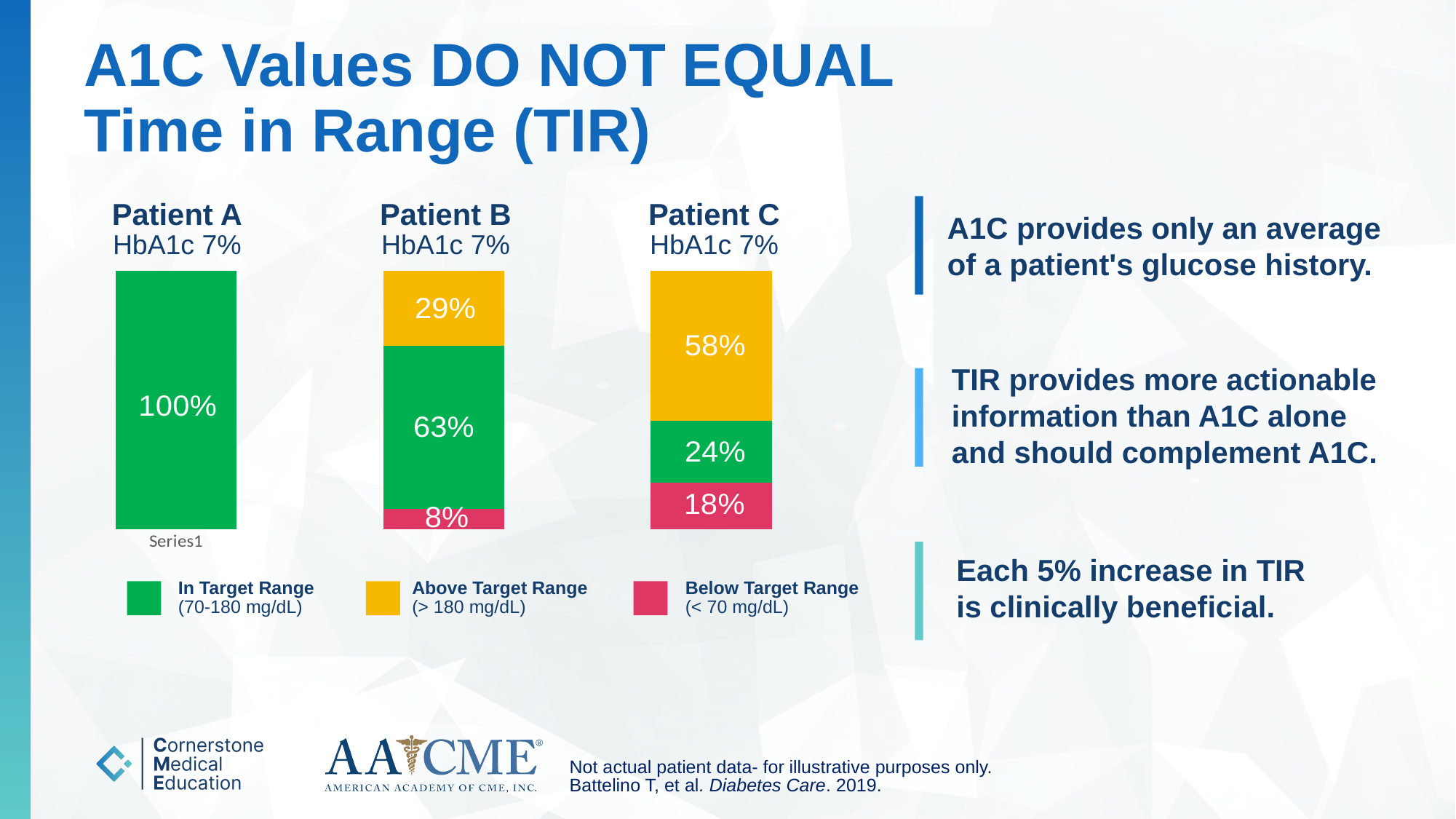
In the Patient C chart, what percentage of time is Above Target Range? 58% In the Patient A chart, what percentage of time is In Target Range? 100% What is the difference between the In Target Range value for Patient B and the In Target Range value for Patient C? 39% Which is larger: the Above Target Range value for Patient B or the Above Target Range value for Patient C? Patient C In the Patient C chart, which range category has the largest share of time? Above Target Range In the Patient B chart, which range category has the smallest share of time? Below Target Range In the Patient C chart, what percentage of time is Below Target Range? 18% What type of chart is used to show each patient's time in range? Stacked bar chart How many range categories does the legend list? 3 What colour represents Below Target Range in the charts? Pink/red In the Patient B chart, what percentage of time is In Target Range? 63% In the Patient B chart, what percentage of time is Below Target Range? 8%